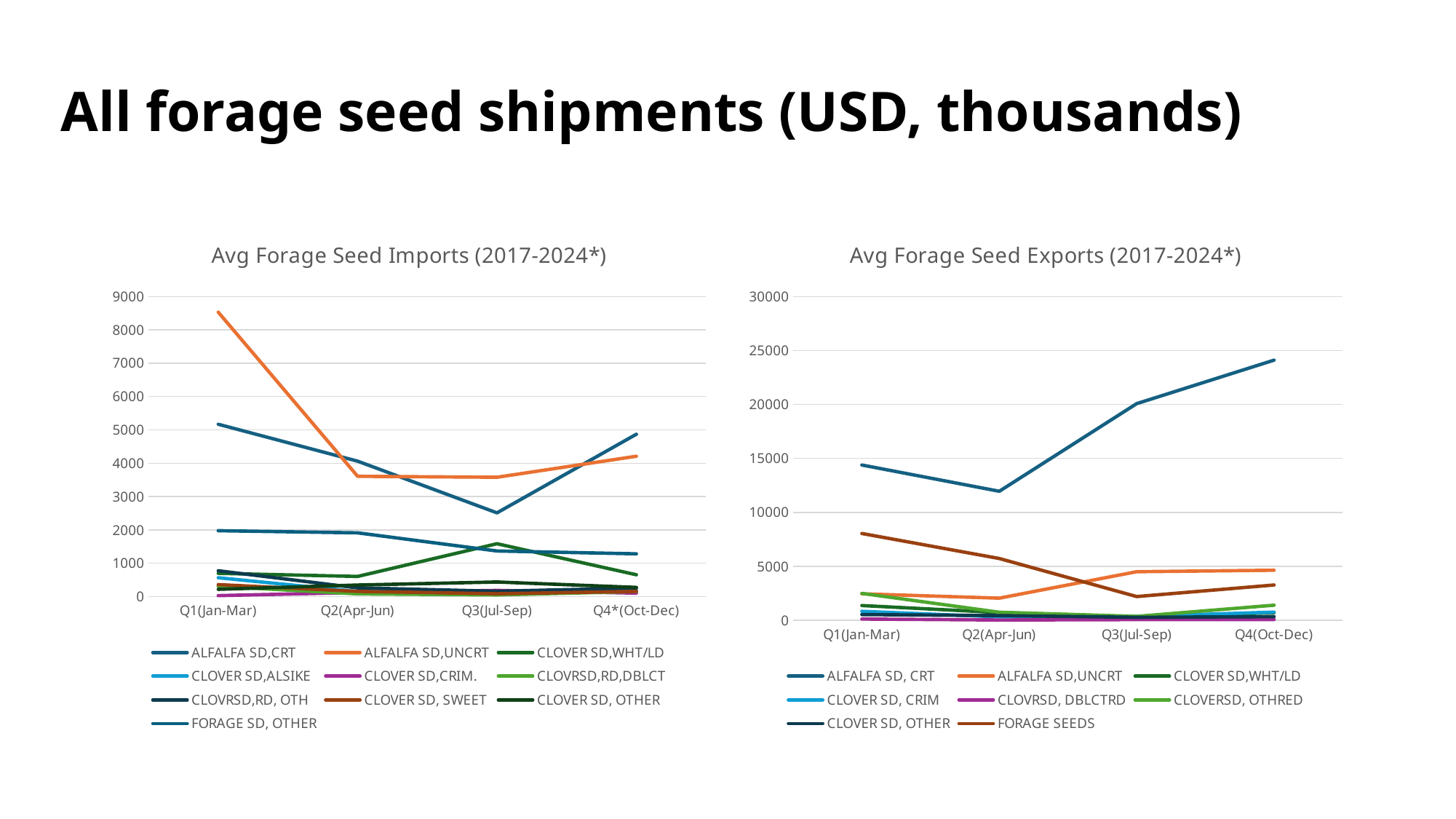
In the Avg Forage Seed Imports (2017-2024*) chart, which series has the highest value at Q1(Jan-Mar)? ALFALFA SD,UNCRT In the Avg Forage Seed Imports (2017-2024*) chart, is the value for ALFALFA SD,CRT at Q3(Jul-Sep) greater or less than 3000? less How many series does the legend of the Avg Forage Seed Exports (2017-2024*) chart list? 8 In the Avg Forage Seed Imports (2017-2024*) chart, is the value for ALFALFA SD,UNCRT at Q1(Jan-Mar) greater or less than 8000? greater How many quarters are shown on the x axis of the Avg Forage Seed Exports (2017-2024*) chart? 4 In the Avg Forage Seed Exports (2017-2024*) chart, is the value for ALFALFA SD, CRT at Q4(Oct-Dec) greater or less than 20000? greater In the Avg Forage Seed Exports (2017-2024*) chart, which is larger at Q1(Jan-Mar): ALFALFA SD, CRT or FORAGE SEEDS? ALFALFA SD, CRT How many series does the legend of the Avg Forage Seed Imports (2017-2024*) chart list? 10 In the Avg Forage Seed Exports (2017-2024*) chart, does the ALFALFA SD, CRT line rise or fall from Q2(Apr-Jun) to Q4(Oct-Dec)? rise What kind of chart is the Avg Forage Seed Imports (2017-2024*) chart? line chart In the Avg Forage Seed Exports (2017-2024*) chart, which series has the highest value at Q4(Oct-Dec)? ALFALFA SD, CRT